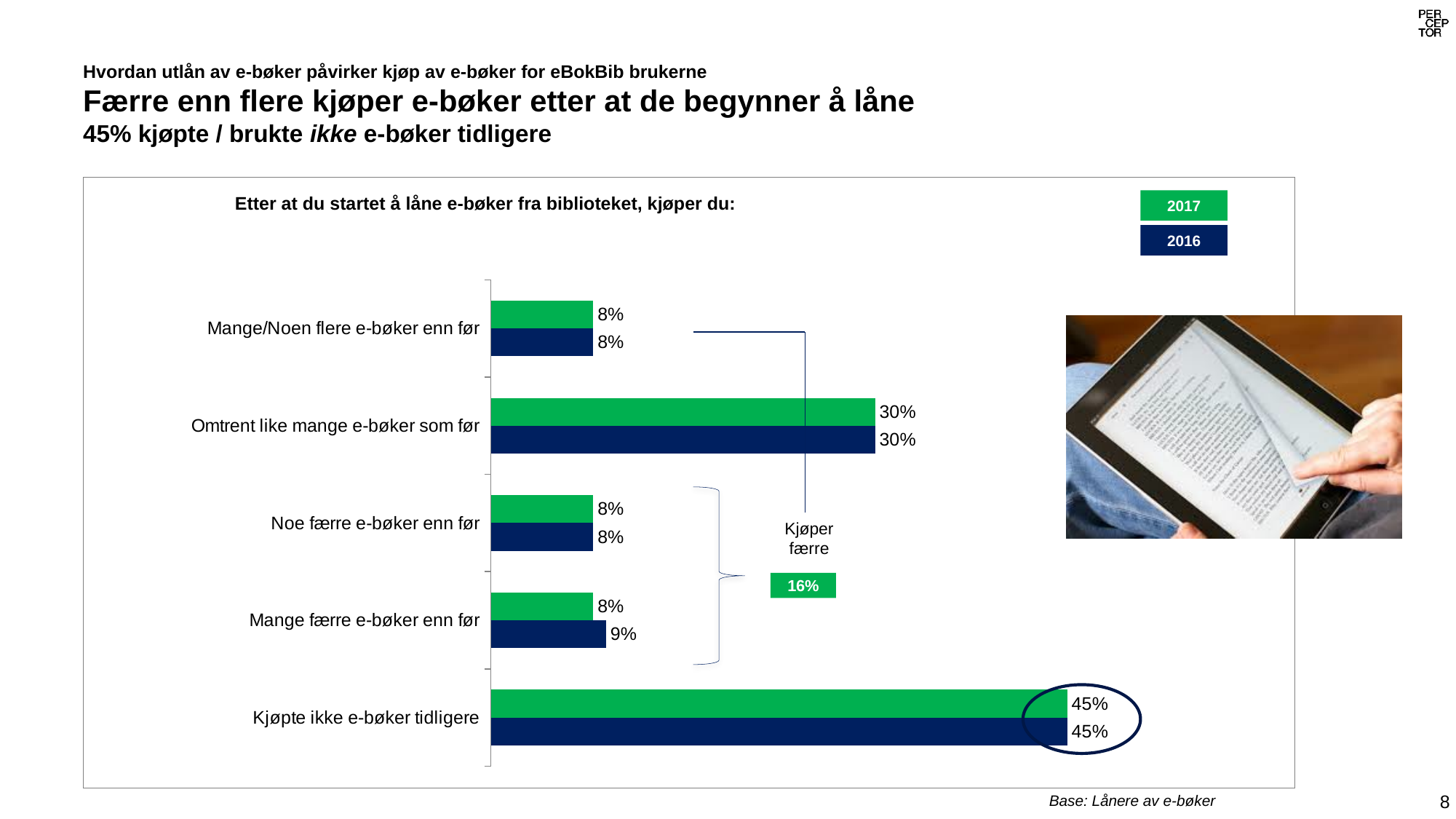
How many categories are shown on the chart? 5 Which category has the highest 2017 value? Kjøpte ikke e-bøker tidligere How many series does the legend list? 2 What percentage is shown in the 'Kjøper færre' callout box? 16% What is the difference between the 2016 values for 'Omtrent like mange e-bøker som før' and 'Mange/Noen flere e-bøker enn før'? 22% What is the 2017 value for 'Kjøpte ikke e-bøker tidligere'? 45% Which is larger for 'Mange færre e-bøker enn før': the 2017 value or the 2016 value? 2016 What is the 2016 value for 'Mange færre e-bøker enn før'? 9% What is the 2016 value for 'Noe færre e-bøker enn før'? 8% Which year does the green series represent in the legend? 2017 What kind of chart is shown on the slide? Bar chart What is the 2017 value for 'Omtrent like mange e-bøker som før'? 30%